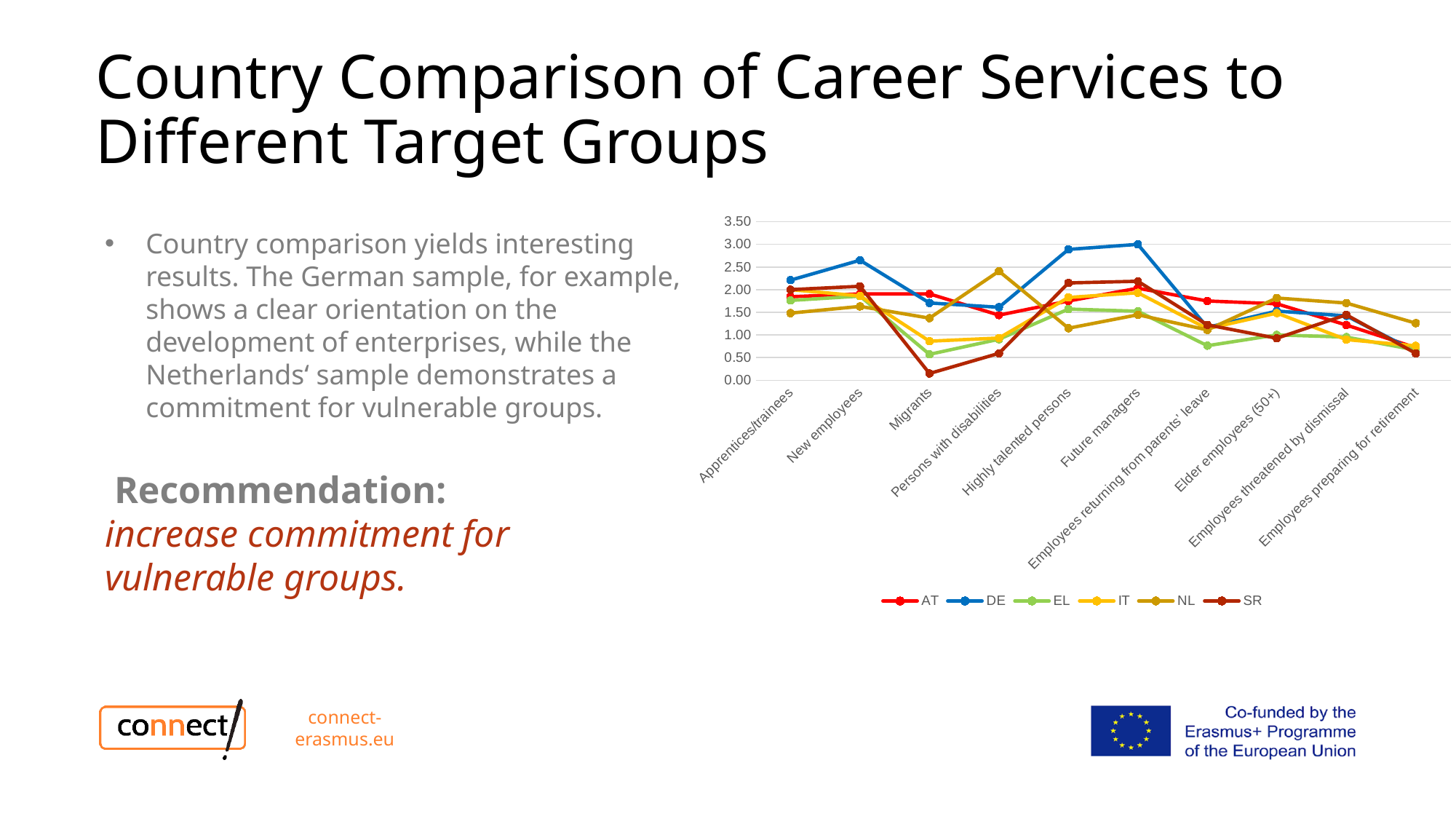
How many series does the chart legend list? 6 Is the NL value for Persons with disabilities greater or less than 2.00? greater Which series has the lowest value for Employees returning from parents' leave? EL Is the SR value for Migrants greater or less than 0.50? less Is the DE value for New employees greater or less than 2.50? greater Which series has the highest value for Future managers? DE How many target-group categories are shown on the x axis of the chart? 10 Which series has the highest value for Persons with disabilities? NL Does the DE line rise or fall from Future managers to Employees returning from parents' leave? fall For Migrants, which series has the larger value, DE or SR? DE Which series has the lowest value for Migrants? SR What kind of chart is shown on the slide? line chart